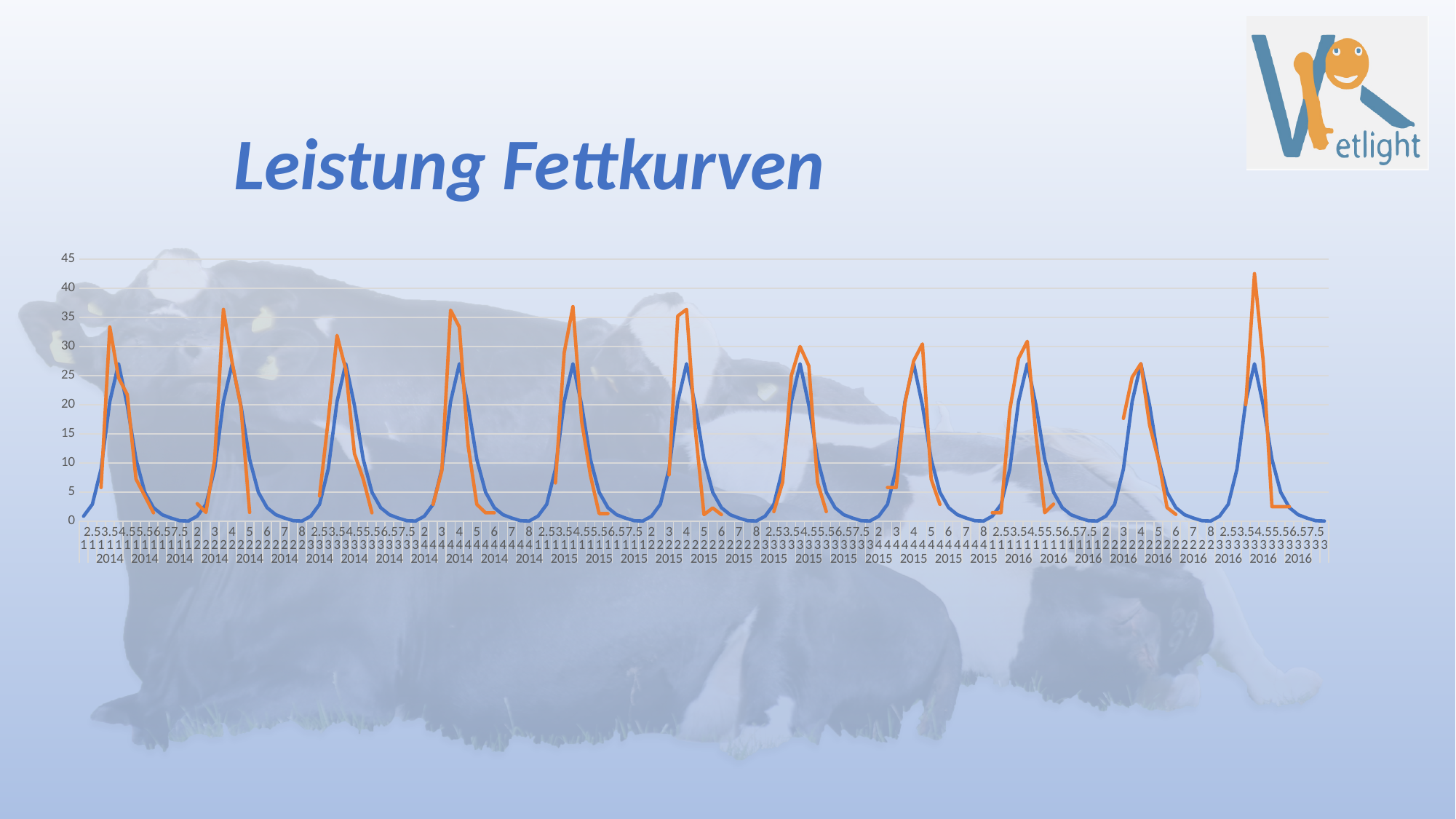
How many lines (series) are plotted on the chart? 2 In which year does the orange line reach its highest peak? 2016 Which line reaches higher peaks overall, the orange line or the blue line? orange Do the values of the lines stay roughly level, rise steadily, or fall steadily across the x axis, or do they repeatedly rise and fall? repeatedly rise and fall What is the title of the chart on the slide? Leistung Fettkurven Is the highest peak of the blue line greater or less than 30? less How many different years are labelled along the x axis? 3 Are the lowest points of the blue line greater or less than 5? less What colours are the two lines on the chart? orange and blue Is the highest peak of the orange line greater or less than 40? greater What kind of chart is shown on the slide? line chart What is the highest value shown on the y axis? 45